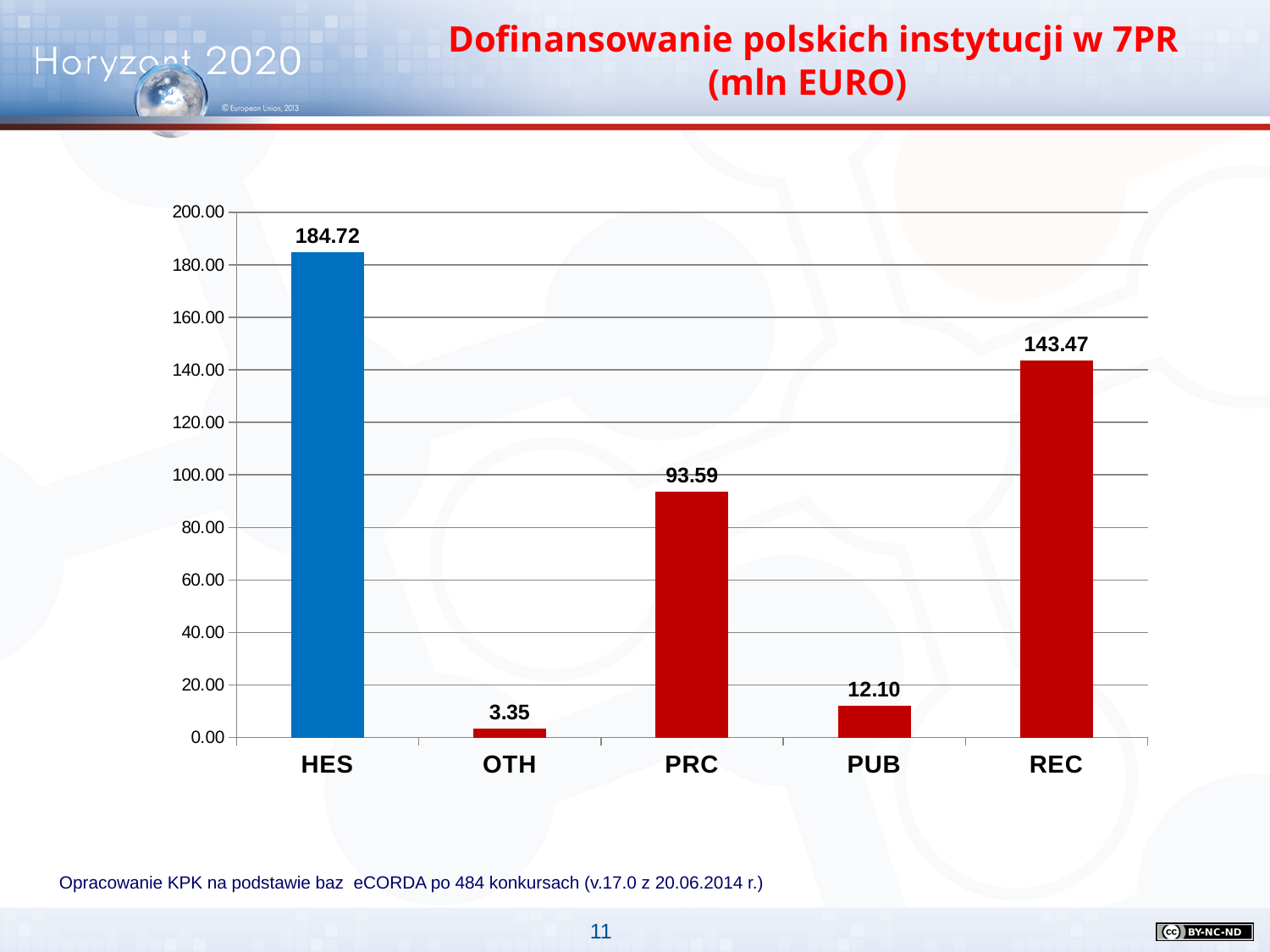
What is the value for REC? 143.47 What is the value for PUB? 12.10 Which is larger, the value for PRC or the value for REC? REC What is the difference between the values for HES and REC? 41.25 How many categories are shown on the x axis? 5 Which bar is coloured blue rather than red? HES What is the value for OTH? 3.35 What is the difference between the values for PRC and PUB? 81.49 What is the value for HES? 184.72 What kind of chart is shown on the slide? bar chart Which category has the highest value? HES Which category has the lowest value? OTH